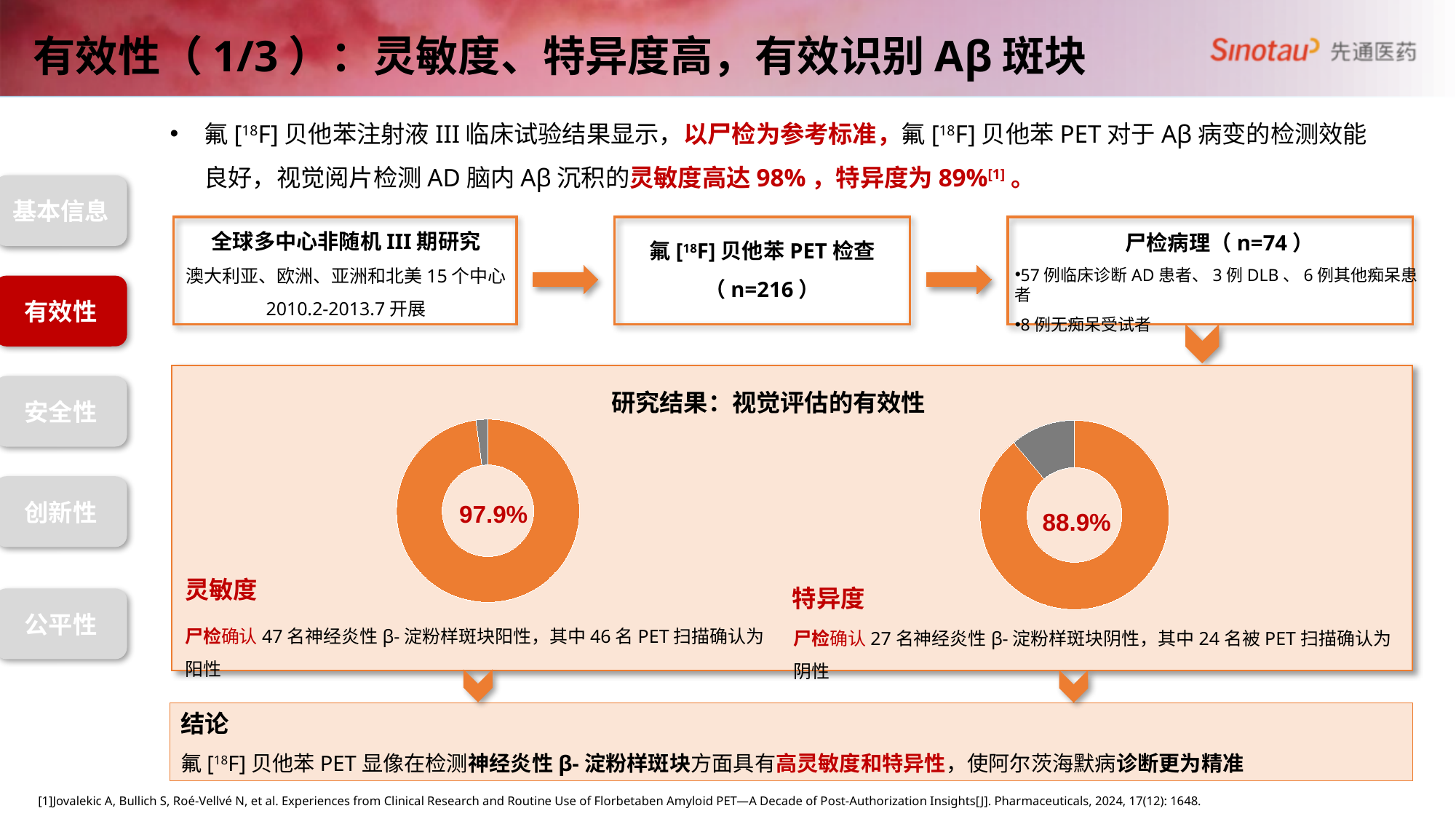
How many slices does the 灵敏度 donut chart have? 2 What colour is the larger slice in both donut charts? Orange Which donut chart has the larger grey slice, 灵敏度 or 特异度? 特异度 What kind of chart is used to display 灵敏度 and 特异度? Donut (pie) chart How many slices does the 特异度 donut chart have? 2 What is the title of the section containing the two donut charts? 研究结果：视觉评估的有效性 Which of the two donut charts shows the larger value, 灵敏度 or 特异度? 灵敏度 What is the difference between the value shown for 灵敏度 and the value shown for 特异度? 9.0% In the 特异度 donut chart, what share of the ring does the orange slice represent? 88.9% What value is shown in the centre of the left donut chart (灵敏度)? 97.9% What value is shown in the centre of the right donut chart (特异度)? 88.9% In the 灵敏度 donut chart, what share of the ring does the orange slice represent? 97.9%